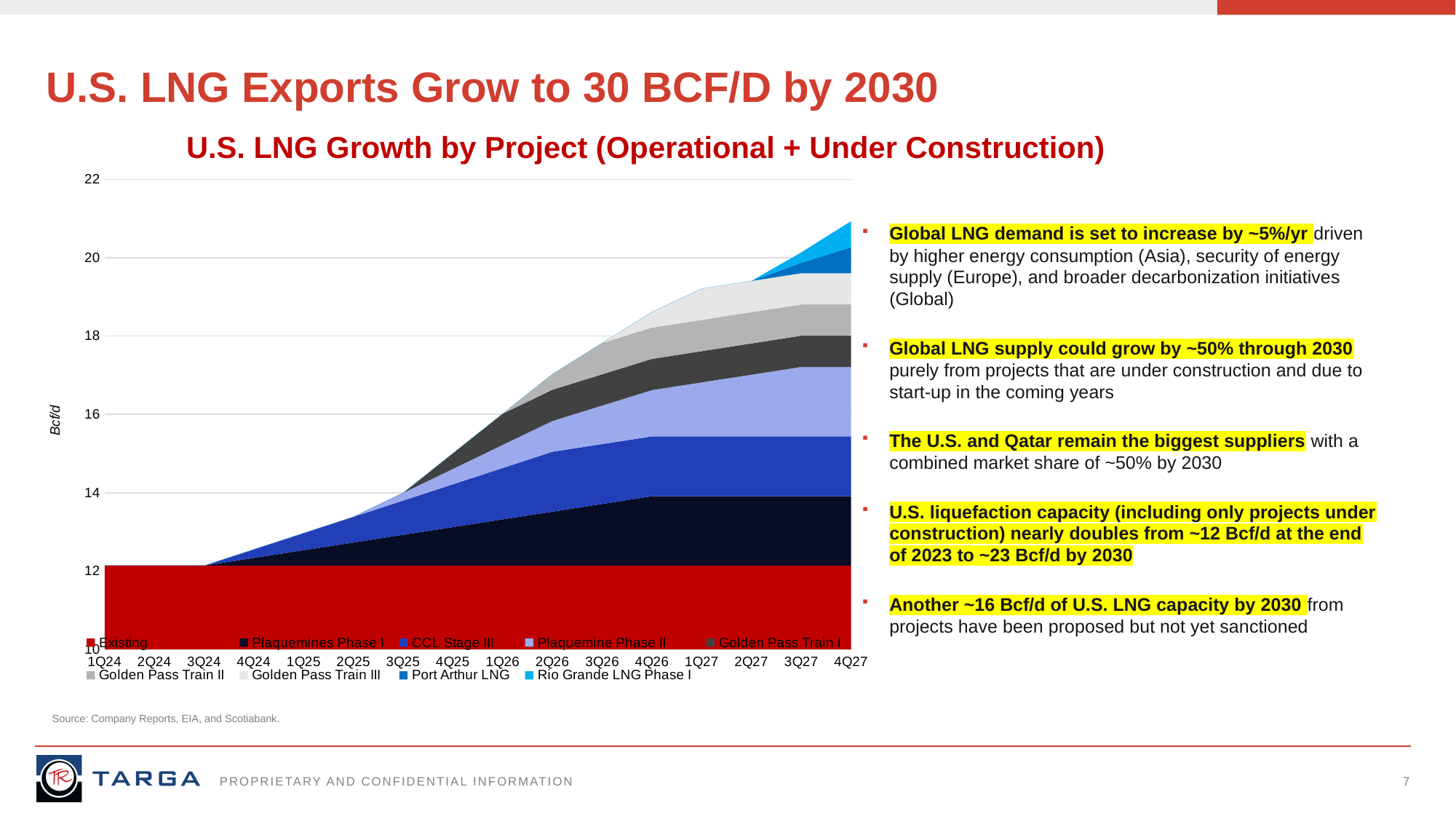
Does the total U.S. LNG capacity rise or fall from 1Q24 to 4Q27? Rise What type of chart is shown on the slide? Stacked area chart Which quarter has the highest total stacked value in the chart? 4Q27 How many series does the chart legend list? 9 Is the total stacked value for 2Q26 greater or less than 16? greater Is the total stacked value for 4Q26 greater or less than 18? greater What is the title of the chart? U.S. LNG Growth by Project (Operational + Under Construction) How many quarters are shown along the x axis of the chart? 16 Is the total stacked value for 1Q25 greater or less than 14? less What is the label on the y axis of the chart? Bcf/d